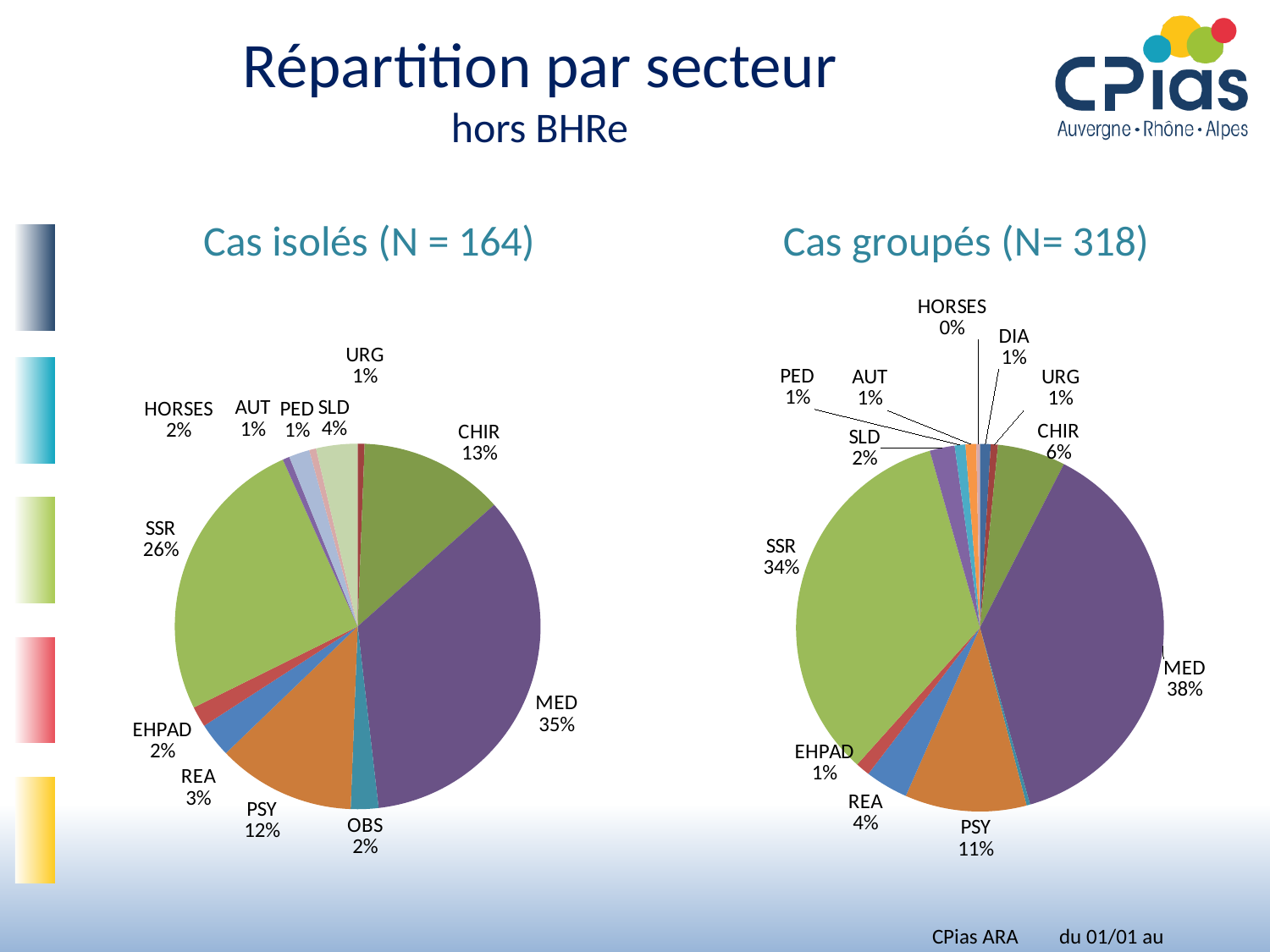
In the 'Cas groupés (N= 318)' chart, what share does REA have? 4% In the 'Cas isolés (N = 164)' chart, which sector has the largest share? MED In the 'Cas groupés (N= 318)' chart, what is the difference between the MED share and the PSY share? 27% Which chart shows a larger share for CHIR, 'Cas isolés' or 'Cas groupés'? Cas isolés In the 'Cas isolés (N = 164)' chart, what share does MED have? 35% What type of chart is used for 'Cas groupés (N= 318)'? Pie chart In the 'Cas groupés (N= 318)' chart, which sector has the smallest share? HORSES How many sectors are labelled in the 'Cas isolés (N = 164)' pie chart? 12 In the 'Cas isolés (N = 164)' chart, which is larger, the PSY share or the SLD share? PSY What is the main title of the slide? Répartition par secteur In the 'Cas groupés (N= 318)' chart, what share does SSR have? 34% In the 'Cas isolés (N = 164)' chart, what is the difference between the SSR share and the CHIR share? 13%